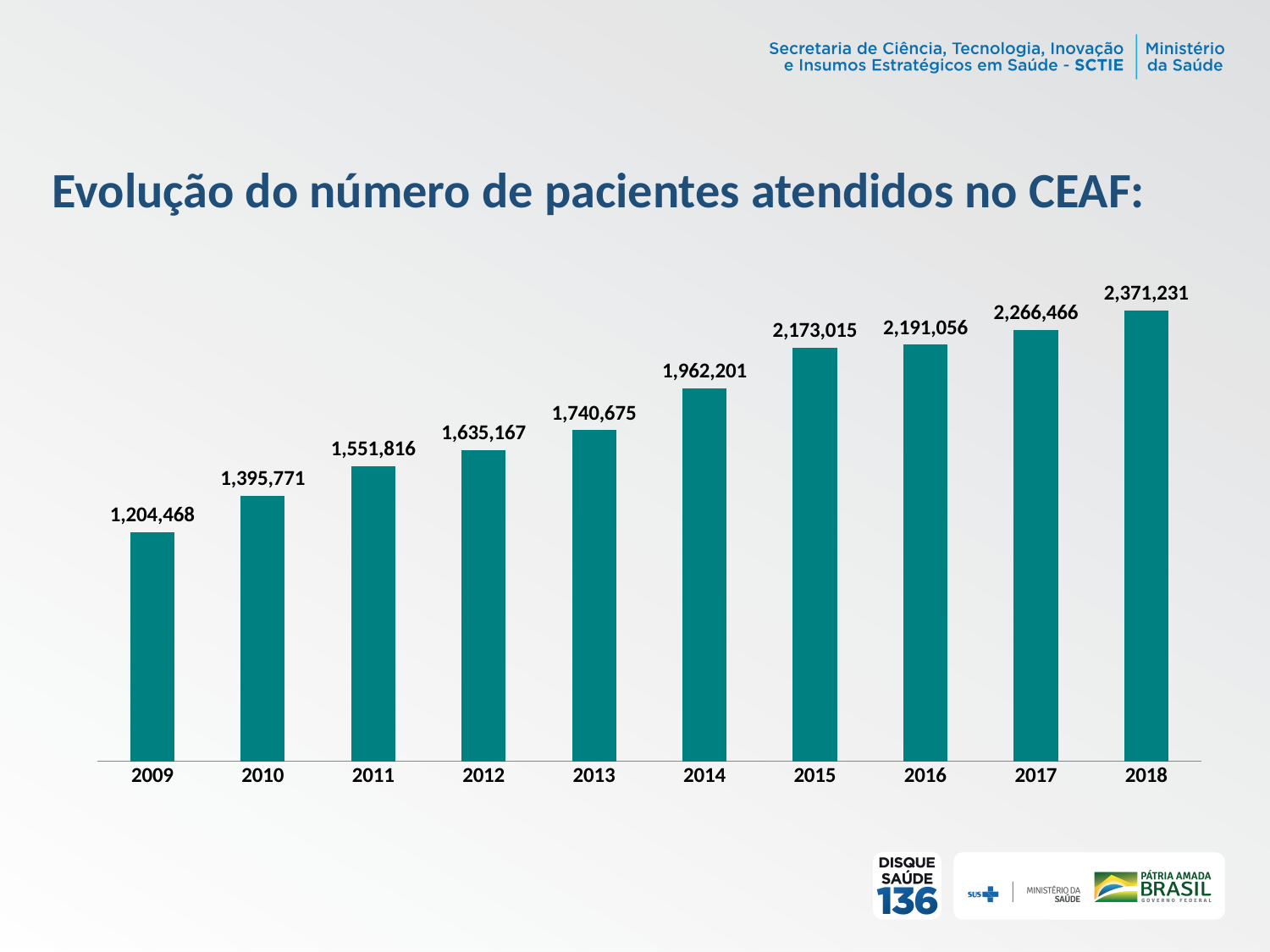
Which year has the highest value? 2018 What is the difference between the values for 2018 and 2009? 1,166,763 What kind of chart is shown on the slide? Bar chart What is the title of the chart? Evolução do número de pacientes atendidos no CEAF: What is the value shown for 2018? 2,371,231 What is the value shown for 2009? 1,204,468 What is the value shown for 2014? 1,962,201 Which is larger, the value for 2012 or the value for 2013? 2013 Do the values rise or fall from 2009 to 2018? Rise Which year has the lowest value? 2009 How many years are shown on the x axis? 10 What is the difference between the values for 2016 and 2015? 18,041